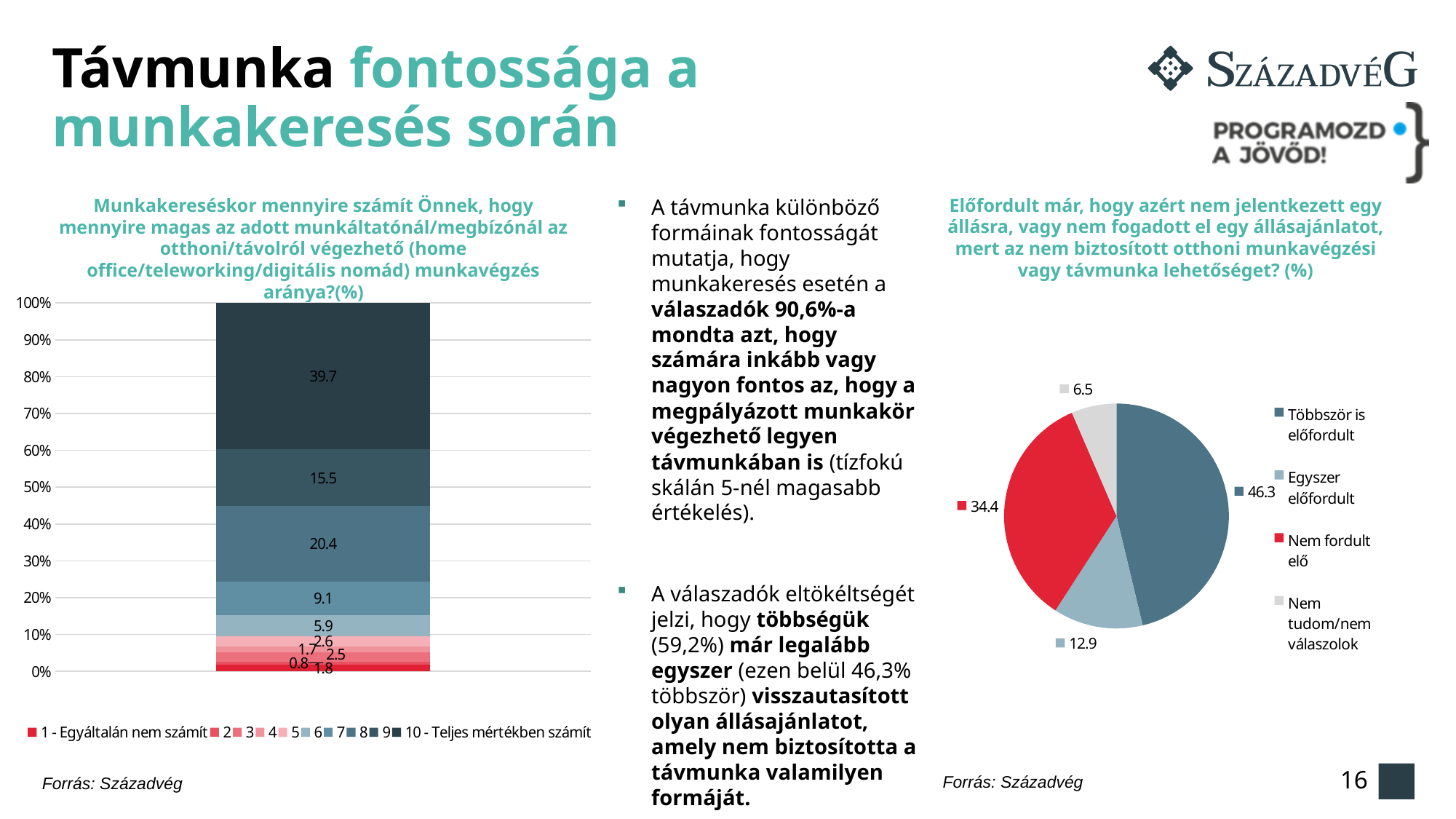
In the pie chart on the right, which category has the largest slice? Többször is előfordult In the pie chart on the right, what is the value for "Nem tudom/nem válaszolok"? 6.5 In the pie chart on the right, what is the difference between the values for "Többször is előfordult" and "Egyszer előfordult"? 33.4 How many series does the legend of the left-hand stacked bar chart list? 10 What kind of chart is the chart on the right side of the slide? Pie chart In the pie chart on the right, which category has the smallest slice? Nem tudom/nem válaszolok In the stacked bar chart on the left, what is the difference between the "10 - Teljes mértékben számít" segment (39.7) and the segment directly below it (15.5)? 24.2 In the pie chart on the right, what is the value for "Többször is előfordult"? 46.3 In the pie chart on the right, which is larger: "Nem fordult elő" or "Egyszer előfordult"? Nem fordult elő How many slices does the pie chart on the right have? 4 What kind of chart is the chart on the left side of the slide? Bar chart In the stacked bar chart on the left, what is the value of the top segment, "10 - Teljes mértékben számít"? 39.7